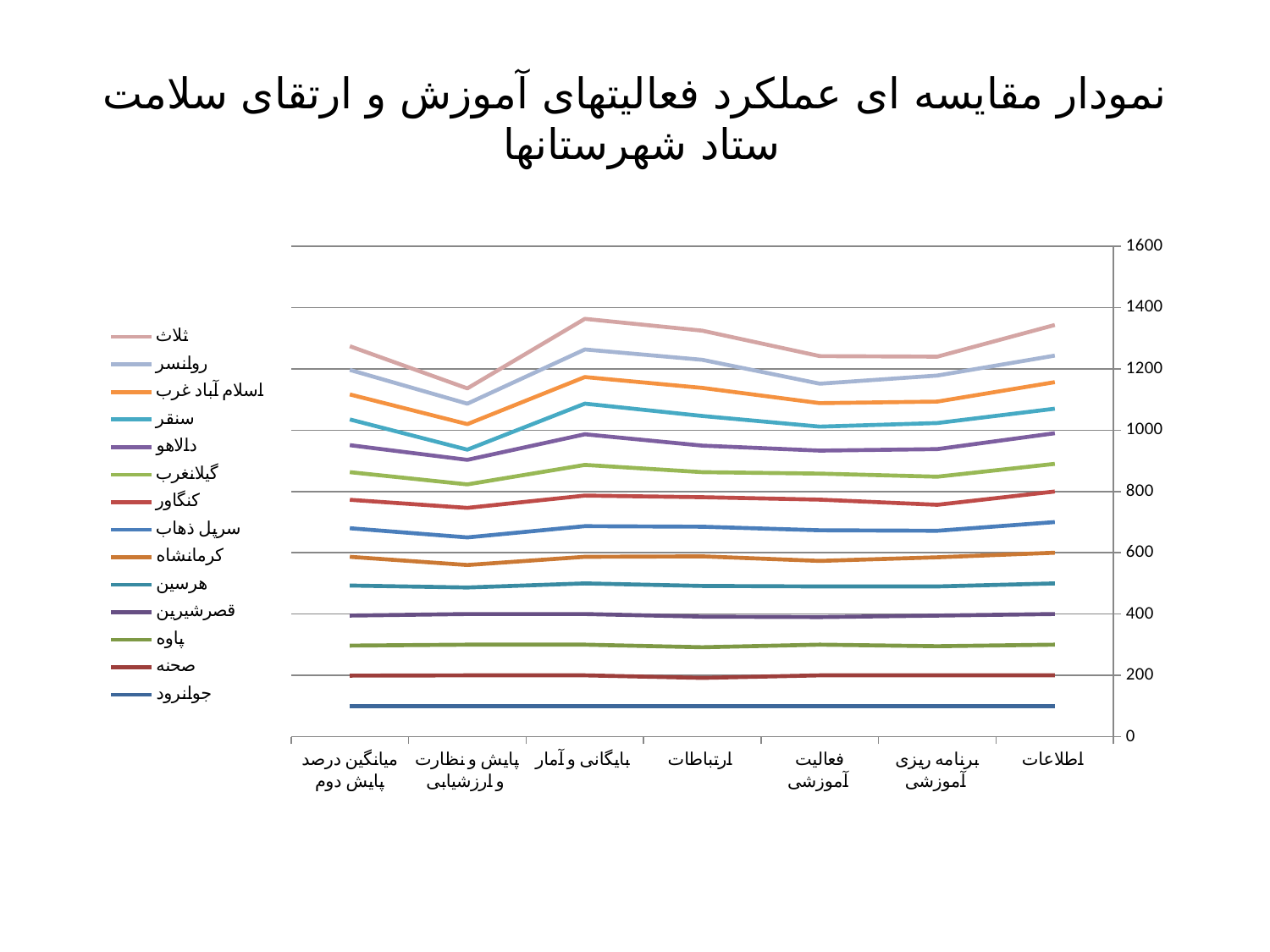
What kind of chart is shown on the slide? line chart What is the title of the chart on the slide? نمودار مقایسه ای عملکرد فعالیتهای آموزش و ارتقای سلامت ستاد شهرستانها How many series does the legend list? 14 Is the value for جوانرود at اطلاعات greater or less than 200? less Is the value for کنگاور at پایش و نظارت و ارزشیابی greater or less than 800? less How many categories are shown along the x axis? 7 Is the value for سنقر at پایش و نظارت و ارزشیابی greater or less than 1000? less For the series ثلاث, which category has the lowest value? پایش و نظارت و ارزشیابی